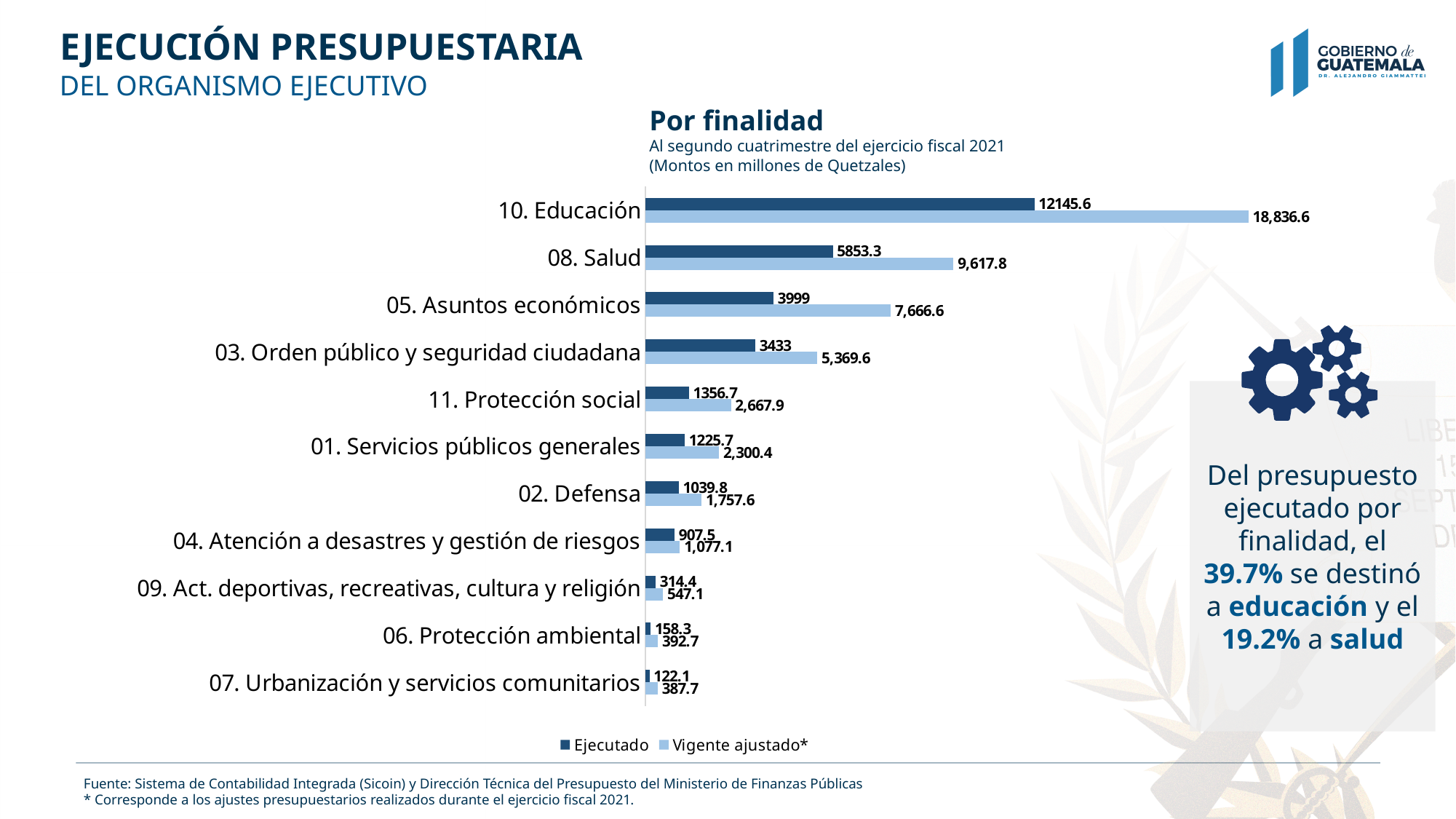
What kind of chart is shown on the slide? Bar chart What is the Vigente ajustado* value for 06. Protección ambiental? 392.7 Which is larger: the Ejecutado value for 05. Asuntos económicos or the Ejecutado value for 03. Orden público y seguridad ciudadana? 05. Asuntos económicos What is the Ejecutado value for 10. Educación? 12145.6 What is the difference between the Vigente ajustado* and Ejecutado values for 08. Salud? 3,764.5 Which category has the highest Ejecutado value? 10. Educación What is the Vigente ajustado* value for 08. Salud? 9,617.8 What is the difference between the Vigente ajustado* and Ejecutado values for 10. Educación? 6,691.0 How many series does the legend list? 2 What is the Ejecutado value for 02. Defensa? 1039.8 How many categories are shown in the chart? 11 Which category has the lowest Ejecutado value? 07. Urbanización y servicios comunitarios